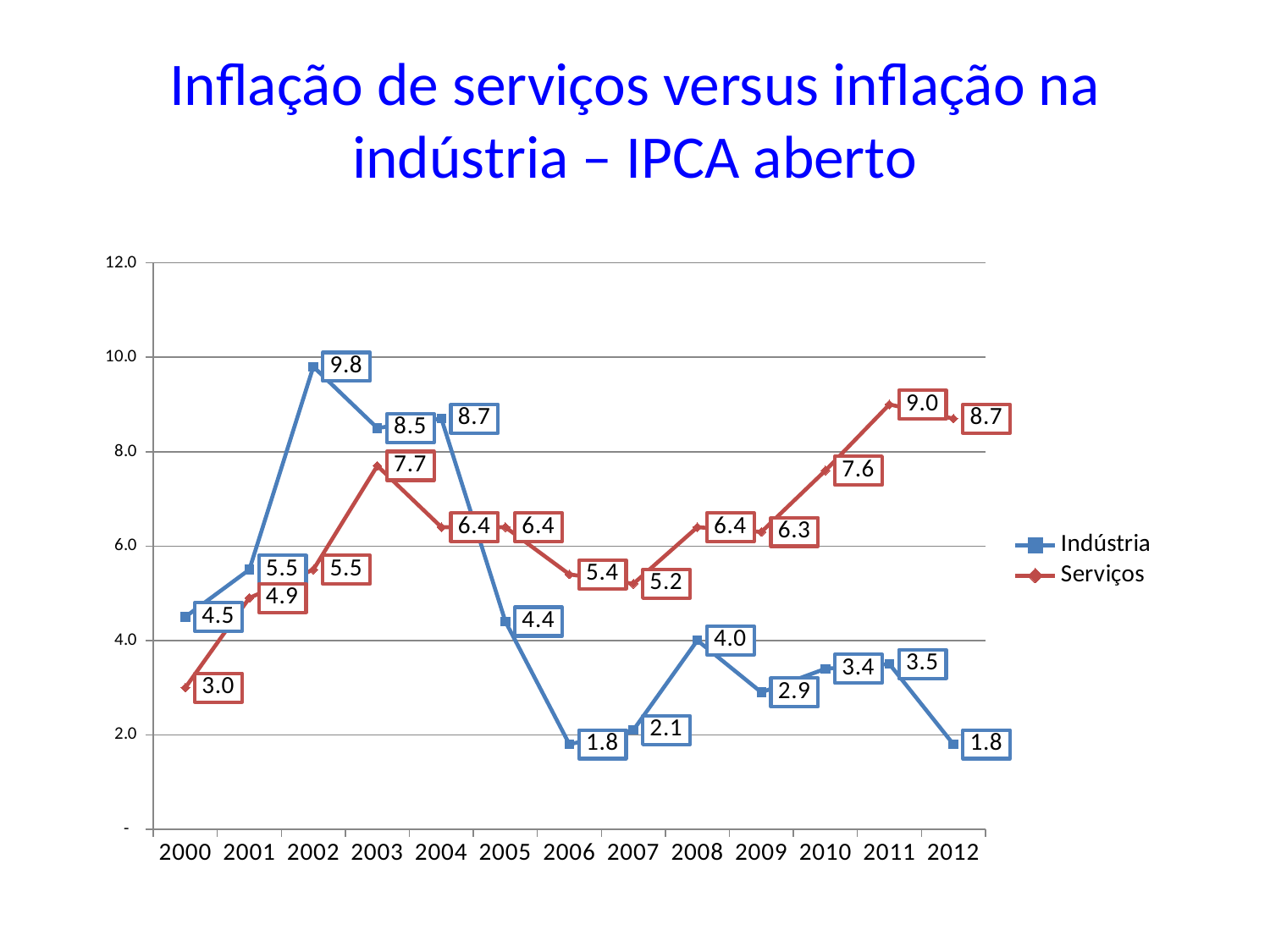
What is the Serviços value for 2000? 3.0 How many years are shown on the x axis? 13 In which year does the Serviços series have its lowest value? 2000 What is the difference between the Serviços and Indústria values in 2012? 6.9 Which series has the higher value in 2004, Indústria or Serviços? Indústria Does the Serviços series rise or fall from 2009 to 2011? Rise What is the Indústria value for 2002? 9.8 What is the Serviços value for 2011? 9.0 What kind of chart is shown on the slide? Line chart What is the Indústria value for 2012? 1.8 How many series does the legend list? 2 In which year does the Indústria series reach its highest value? 2002